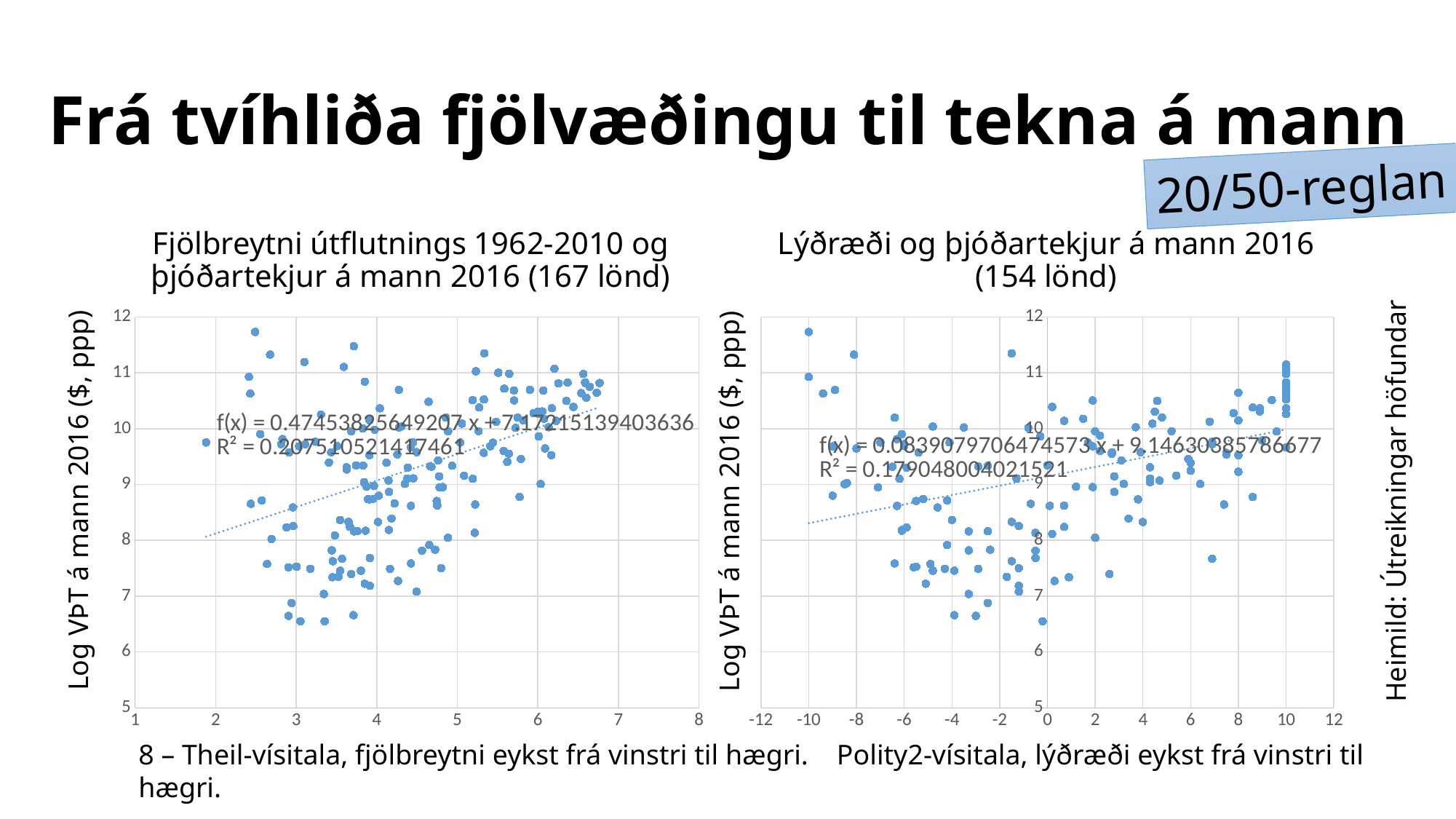
According to its title, how many countries are plotted in the left chart (Fjölbreytni útflutnings)? 167 Which chart has the higher R² value, the left chart (Fjölbreytni útflutnings) or the right chart (Lýðræði)? The left chart (Fjölbreytni útflutnings) In the left chart (Fjölbreytni útflutnings), what is the slope of the fitted line f(x)? 0.47453825649207 What is the y-axis label of the left chart (Fjölbreytni útflutnings)? Log VÞT á mann 2016 ($, ppp) In the right chart (Lýðræði og þjóðartekjur á mann 2016), what is the R² value shown for the trend line? 0.179048004021521 In the left chart (Fjölbreytni útflutnings), does the trend line rise or fall from left to right along the x axis? Rises In the right chart (Lýðræði og þjóðartekjur á mann 2016), does the trend line rise or fall from left to right along the x axis? Rises In the left chart (Fjölbreytni útflutnings), what is the R² value shown for the trend line? 0.207510521417461 According to its title, how many countries are plotted in the right chart (Lýðræði og þjóðartekjur á mann 2016)? 154 What kind of chart is the left chart, titled 'Fjölbreytni útflutnings 1962-2010 og þjóðartekjur á mann 2016'? Scatter chart In the right chart (Lýðræði og þjóðartekjur á mann 2016), what is the intercept of the fitted line f(x)? 9.14630885786677 What kind of chart is the right chart, titled 'Lýðræði og þjóðartekjur á mann 2016'? Scatter chart